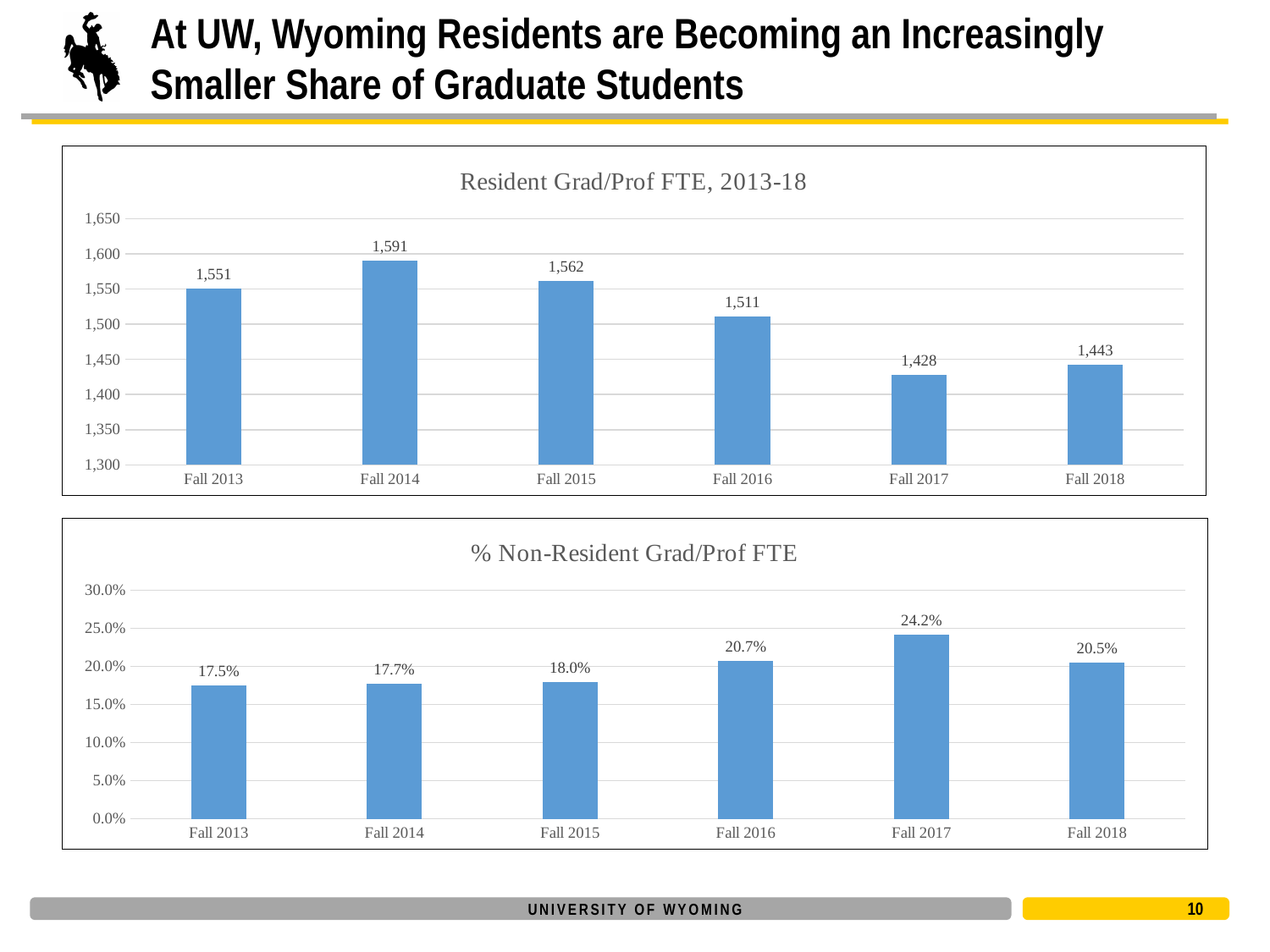
In the '% Non-Resident Grad/Prof FTE' chart, what is the difference between the Fall 2017 and Fall 2013 values? 6.7% In the '% Non-Resident Grad/Prof FTE' chart, do the values generally rise or fall from Fall 2013 to Fall 2017? Rise In the 'Resident Grad/Prof FTE, 2013-18' chart, which period has the lowest value? Fall 2017 In the '% Non-Resident Grad/Prof FTE' chart, what is the value for Fall 2017? 24.2% In the '% Non-Resident Grad/Prof FTE' chart, is the value for Fall 2016 greater or less than 20.0%? greater In the '% Non-Resident Grad/Prof FTE' chart, which period has the lowest value? Fall 2013 In the 'Resident Grad/Prof FTE, 2013-18' chart, what is the value for Fall 2016? 1,511 In the 'Resident Grad/Prof FTE, 2013-18' chart, which period has the highest value? Fall 2014 What kind of chart is the 'Resident Grad/Prof FTE, 2013-18' chart? Bar chart In the 'Resident Grad/Prof FTE, 2013-18' chart, how many periods are shown on the x axis? 6 In the 'Resident Grad/Prof FTE, 2013-18' chart, which is larger, the value for Fall 2013 or Fall 2015? Fall 2015 In the 'Resident Grad/Prof FTE, 2013-18' chart, what is the difference between the Fall 2014 and Fall 2018 values? 148